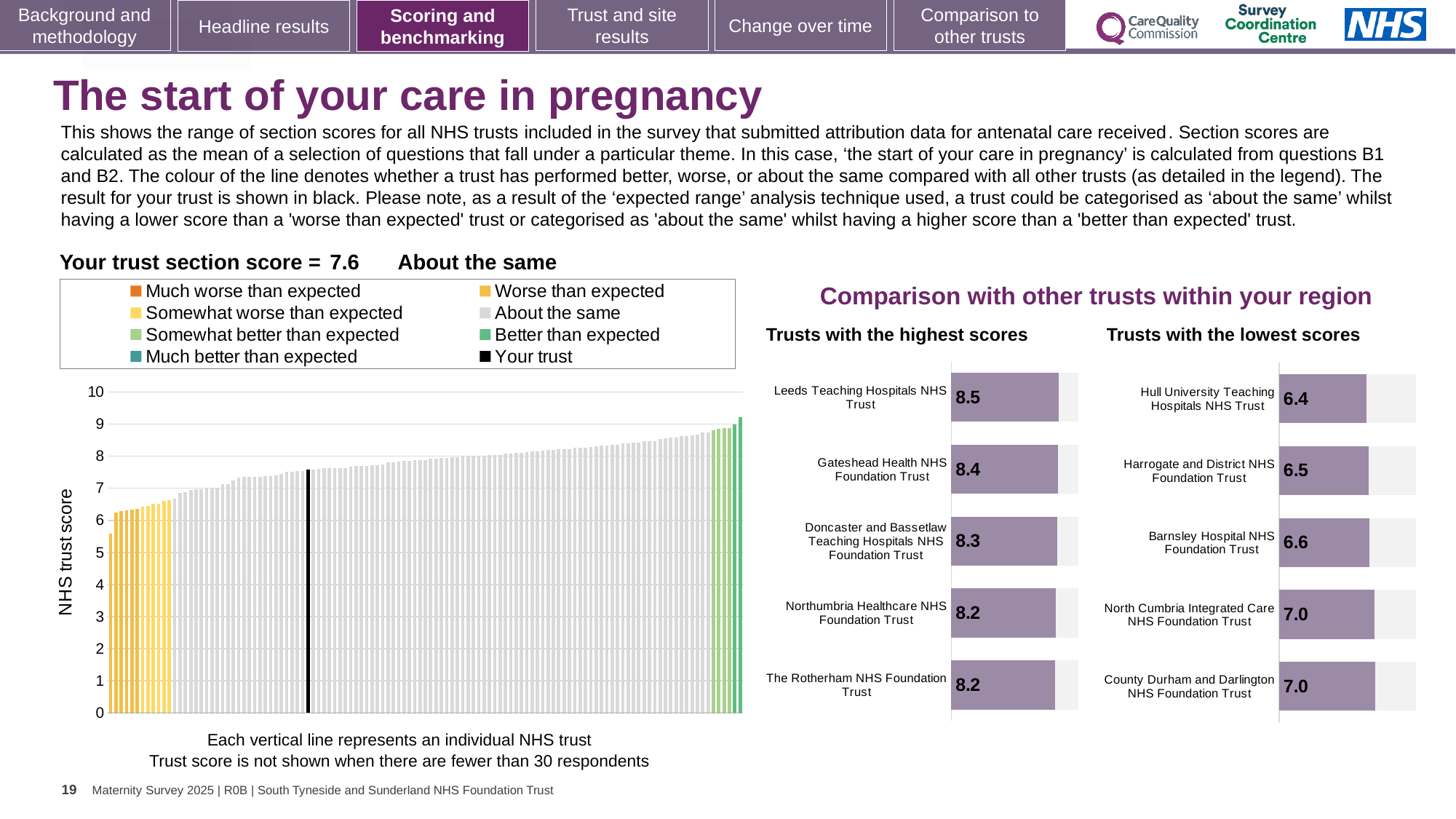
In the 'Trusts with the lowest scores' chart, what is the score for Barnsley Hospital NHS Foundation Trust? 6.6 In the 'Trusts with the lowest scores' chart, which trust has the lowest score? Hull University Teaching Hospitals NHS Trust In the 'Trusts with the highest scores' chart, which trust has the highest score? Leeds Teaching Hospitals NHS Trust How many entries does the legend of the large chart on the left list? 8 In the 'Trusts with the highest scores' chart, what is the difference between the scores of Leeds Teaching Hospitals NHS Trust and The Rotherham NHS Foundation Trust? 0.3 In the 'Trusts with the lowest scores' chart, what is the difference between the scores of County Durham and Darlington NHS Foundation Trust and Hull University Teaching Hospitals NHS Trust? 0.6 In the large chart on the left, do the trust scores rise or fall from left to right? rise In the 'Trusts with the highest scores' chart, what is the score for Leeds Teaching Hospitals NHS Trust? 8.5 How many trusts are shown in the 'Trusts with the lowest scores' chart? 5 In the large chart on the left, is the value for your trust (the black bar) greater or less than 7? greater What kind of chart is the large chart on the left showing NHS trust scores? bar chart In the 'Trusts with the highest scores' chart, which has the larger score: Gateshead Health NHS Foundation Trust or Northumbria Healthcare NHS Foundation Trust? Gateshead Health NHS Foundation Trust